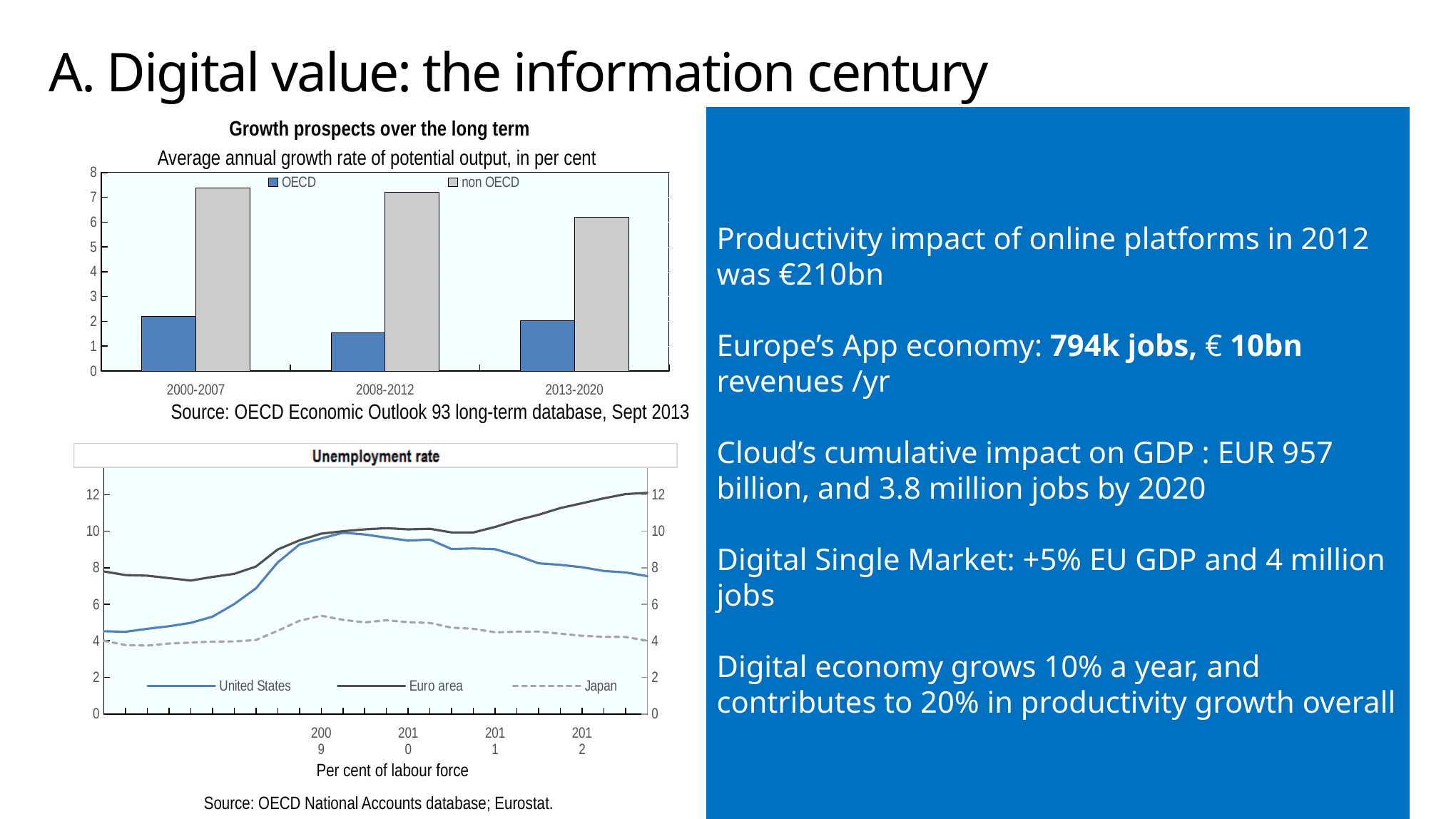
In the 'Unemployment rate' chart, is the Euro area value at the right end of the chart greater or less than 10? greater In the 'Growth prospects over the long term' chart, is the non OECD value for 2000-2007 greater or less than 7? greater In the 'Growth prospects over the long term' chart, which period has the lowest OECD value? 2008-2012 In the 'Growth prospects over the long term' chart, which is larger for 2013-2020, OECD or non OECD? non OECD How many series does the legend of the 'Growth prospects over the long term' chart list? 2 In the 'Growth prospects over the long term' chart, is the OECD value for 2008-2012 greater or less than 2? less How many series does the legend of the 'Unemployment rate' chart list? 3 How many periods are shown on the x axis of the 'Growth prospects over the long term' chart? 3 What kind of chart is the 'Unemployment rate' chart? line chart In the 'Unemployment rate' chart, does the Euro area line rise or fall overall from left to right? rise What kind of chart is the 'Growth prospects over the long term' chart? bar chart In the 'Growth prospects over the long term' chart, which period has the lowest non OECD value? 2013-2020